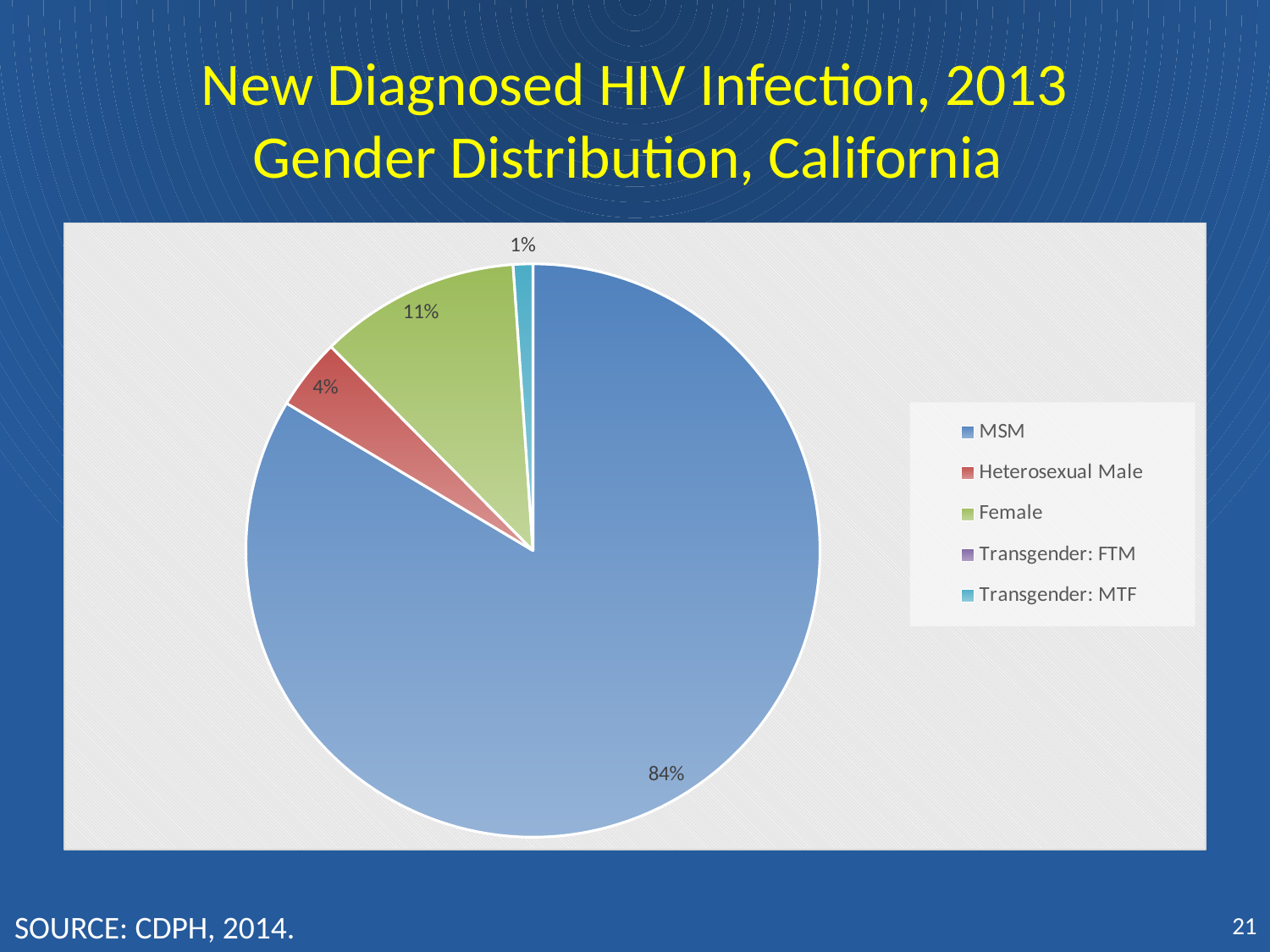
Which is larger, the Female share or the Heterosexual Male share? Female What colour is the Female slice of the pie? green What share of new diagnosed HIV infections is attributed to Heterosexual Male? 4% What is the title of the slide containing the chart? New Diagnosed HIV Infection, 2013 Gender Distribution, California Which category has the largest share of the pie? MSM What kind of chart is shown on the slide? pie chart What share of new diagnosed HIV infections is attributed to Transgender: MTF? 1% Which of the labelled slices has the smallest share of the pie? Transgender: MTF What share of new diagnosed HIV infections is attributed to MSM? 84% How many entries does the legend list? 5 What share of new diagnosed HIV infections is attributed to Female? 11% What is the difference in percentage points between the MSM share and the Female share? 73